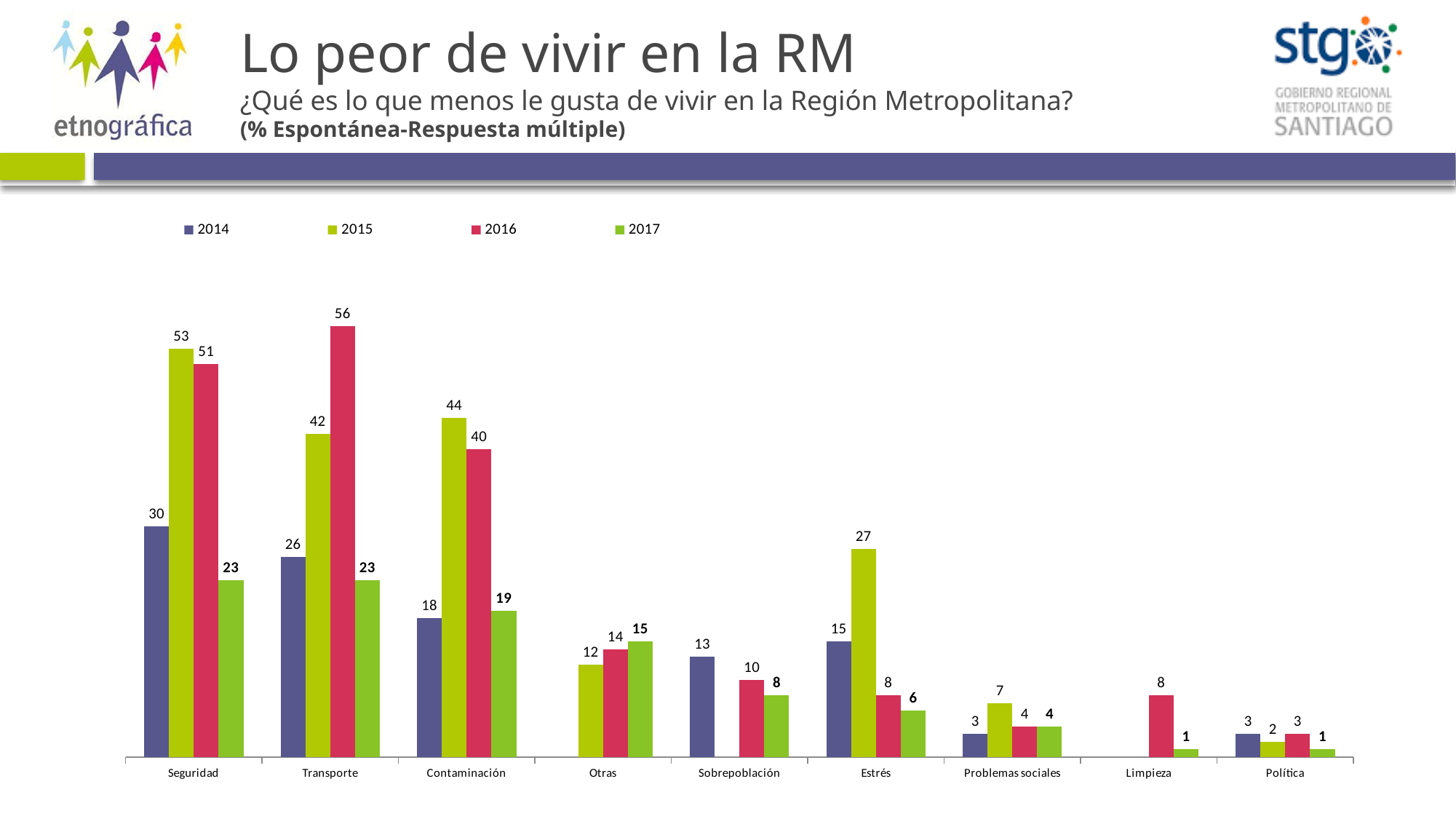
What is the value for Estrés in the 2015 series? 27 Which category has the lowest value in the 2015 series? Política Which is larger for Contaminación: the 2015 value or the 2016 value? 2015 What is the difference between the 2015 and 2017 values for Seguridad? 30 What is the value for Seguridad in the 2015 series? 53 How many series does the legend list? 4 What is the value for Transporte in the 2016 series? 56 What is the value for Contaminación in the 2017 series? 19 Which series is shown in red in the legend? 2016 What kind of chart is shown on the slide? Bar chart How many categories are shown on the x axis? 9 Which category has the highest value in the 2016 series? Transporte